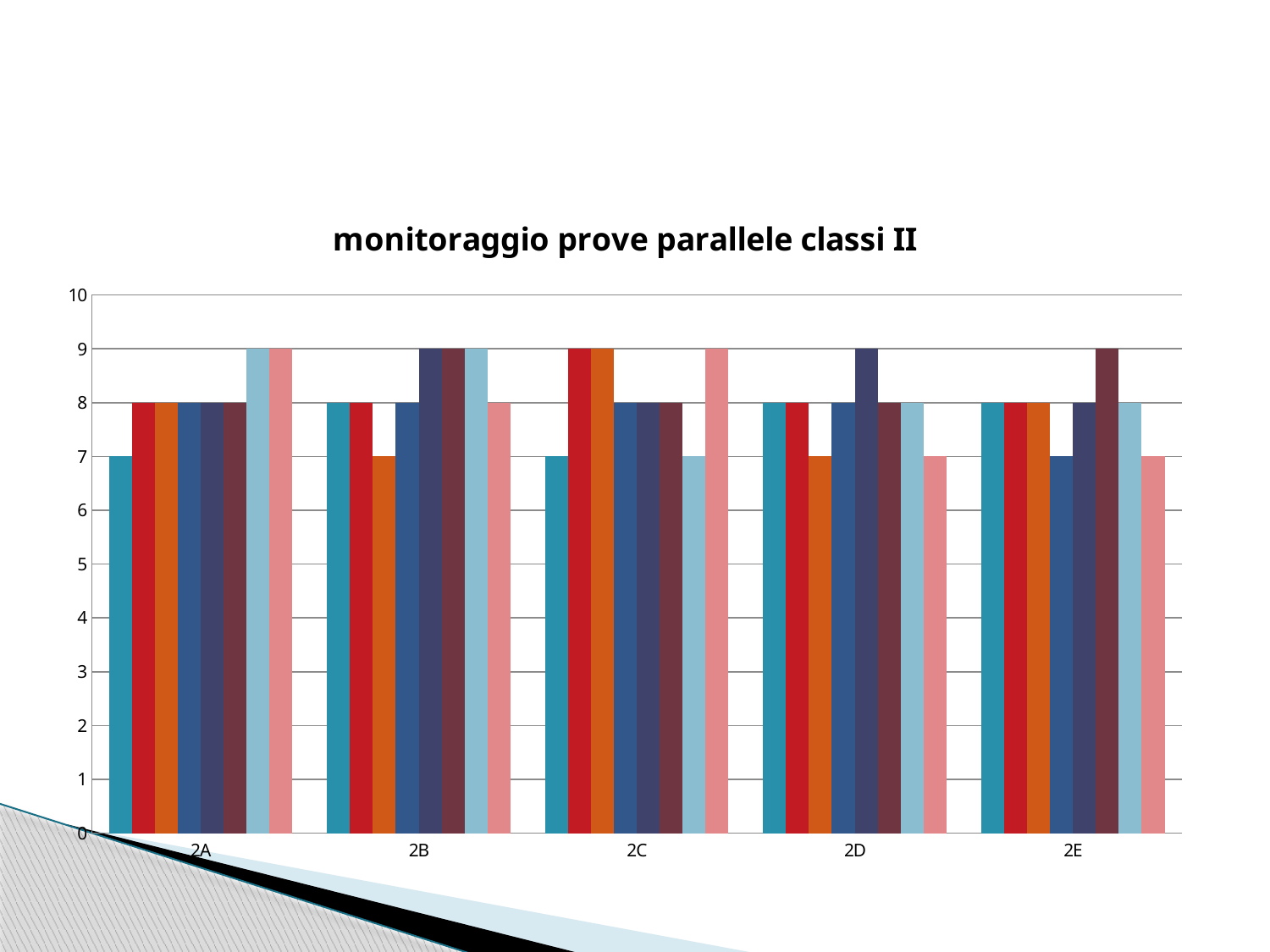
How many classes (categories) are shown on the x axis? 5 What is the value of the rightmost bar for class 2E? 7 What is the title of the chart? monitoraggio prove parallele classi II What is the highest value reached by any bar in the chart? 9 What is the lowest value reached by any bar in the chart? 7 What is the value of the leftmost bar for class 2A? 7 What is the value of the leftmost bar for class 2B? 8 What kind of chart is shown on the slide? bar chart Is the leftmost bar for class 2C greater or less than 8? less What is the value of the rightmost bar for class 2C? 9 What is the maximum value shown on the y axis? 10 How many bars are plotted for each class? 8